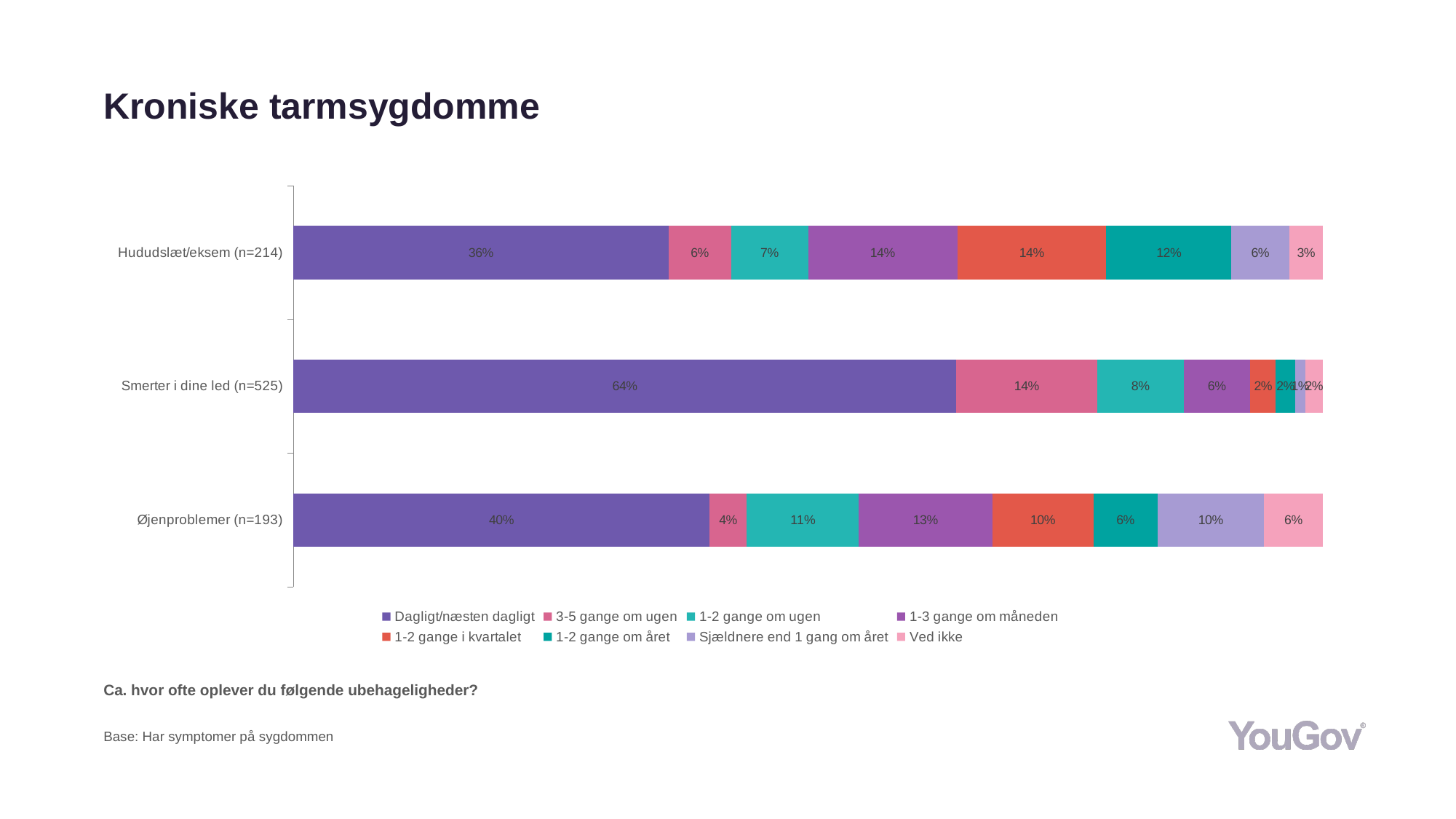
What kind of chart is shown on the slide? Stacked bar chart What is the difference between the Dagligt/næsten dagligt values for Smerter i dine led and Hududslæt/eksem? 28% How many categories are shown on the chart? 3 What percentage of respondents with Øjenproblemer report 1-2 gange om ugen? 11% What is the value for 3-5 gange om ugen for Smerter i dine led? 14% Which category has the highest value for Dagligt/næsten dagligt? Smerter i dine led (n=525) What is the value for Dagligt/næsten dagligt for Smerter i dine led? 64% What percentage of respondents with Hududslæt/eksem report experiencing it Dagligt/næsten dagligt? 36% What is the value for Sjældnere end 1 gang om året for Øjenproblemer? 10% How many series does the legend list? 8 Which category has the lowest value for 3-5 gange om ugen? Øjenproblemer (n=193) Which is larger: the 1-2 gange i kvartalet value for Hududslæt/eksem or for Øjenproblemer? Hududslæt/eksem